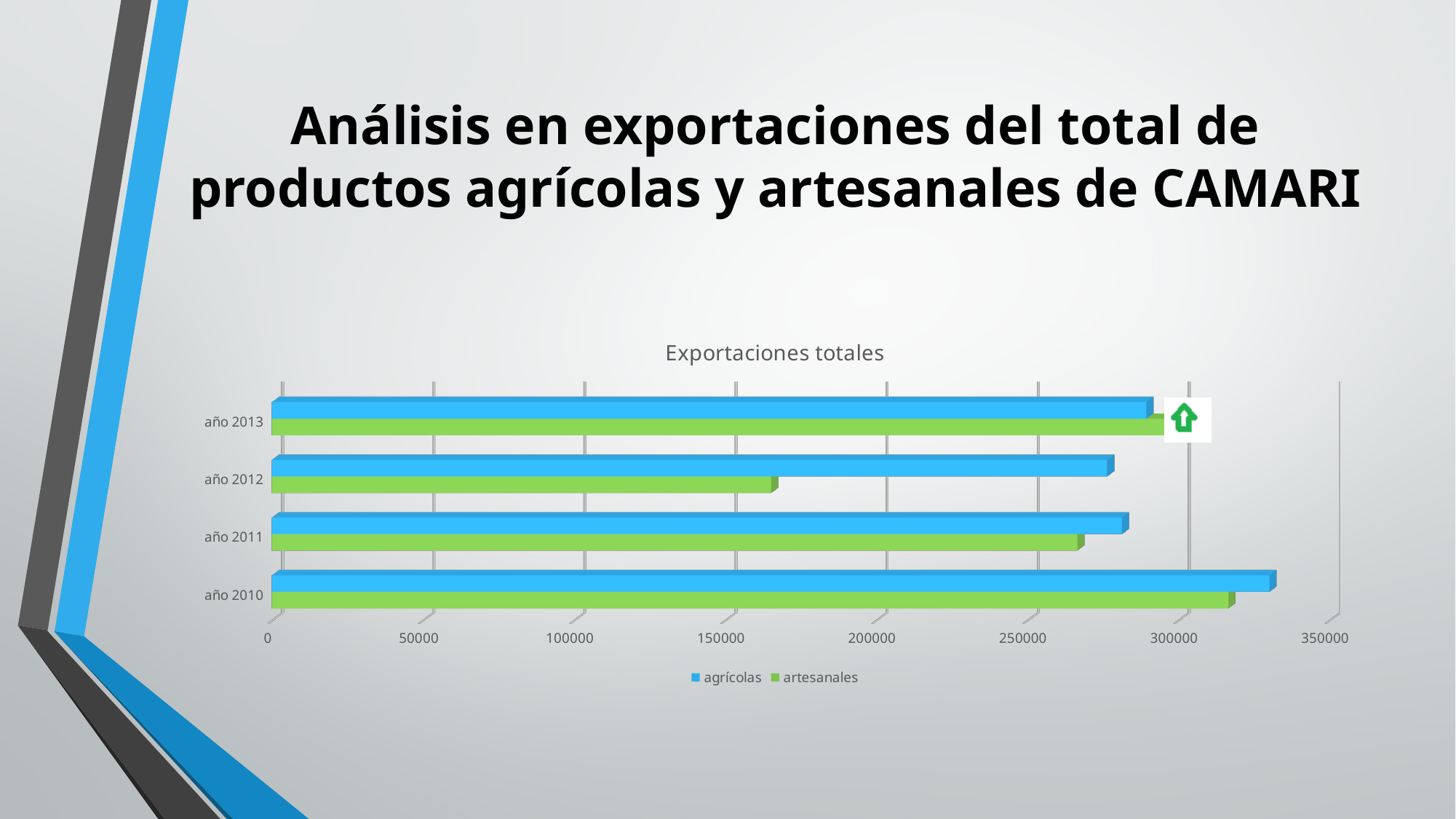
How many series does the legend list? 2 Which year has the highest value for agrícolas? año 2010 Which year has the lowest value for artesanales? año 2012 In año 2012, which is larger: agrícolas or artesanales? agrícolas Is the value for agrícolas in año 2013 greater or less than 250000? greater What is the title of the chart? Exportaciones totales Is the value for artesanales in año 2012 greater or less than 200000? less Is the value for agrícolas in año 2010 greater or less than 300000? greater Which colour represents the artesanales series? green How many years (categories) are plotted on the chart? 4 Which year has the lowest value for agrícolas? año 2012 What kind of chart is shown on the slide? bar chart